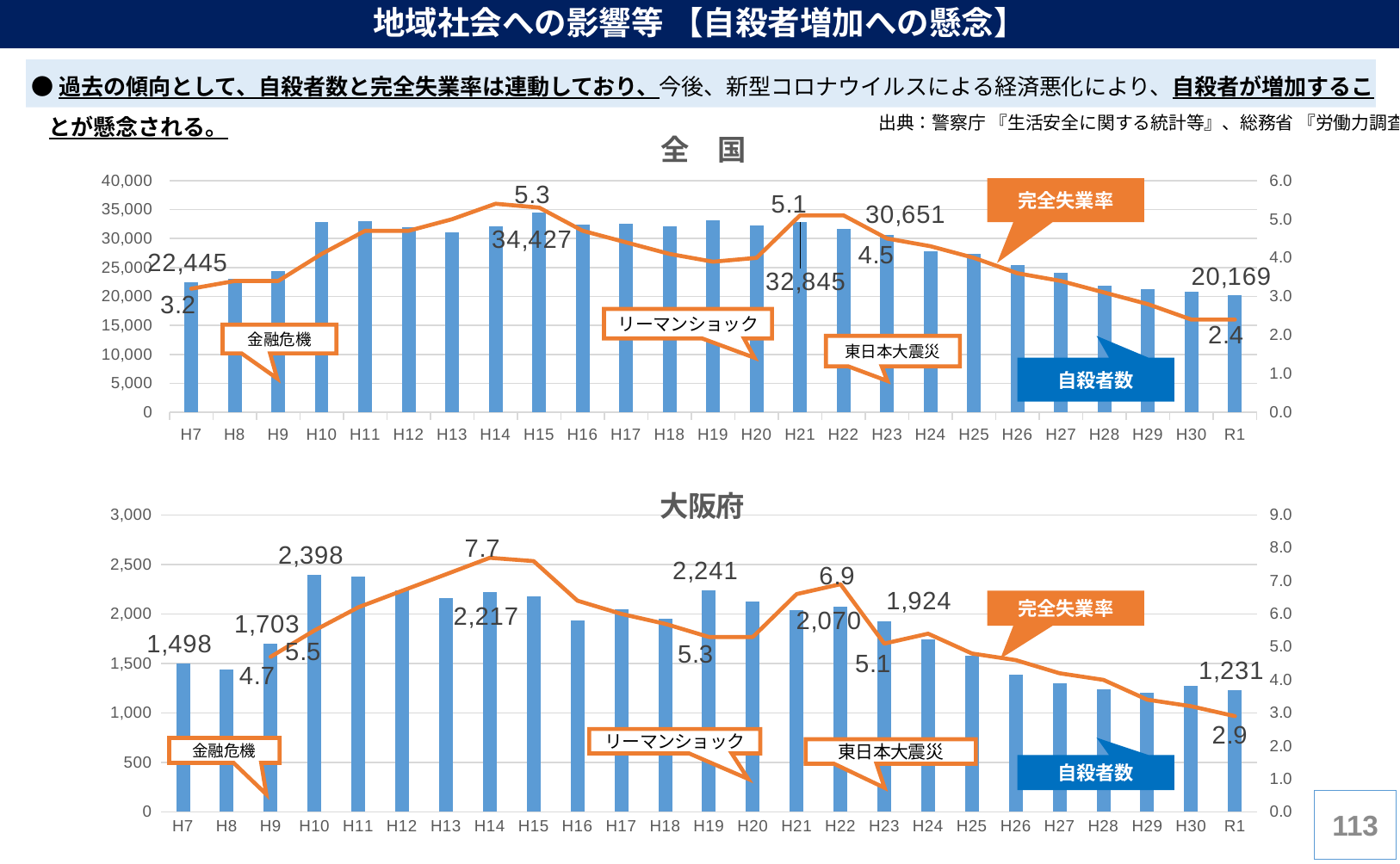
In the 全国 chart, what is the difference between the suicide counts labelled for H21 and H23? 2,194 In the 大阪府 chart, what is the number of suicides labelled for H10? 2,398 In the 全国 chart, what is the difference between the suicide counts labelled for H7 and R1? 2,276 In the 全国 chart, is the suicide count bar for H10 greater or less than 30,000? greater In the 全国 chart, does the unemployment rate line rise or fall from H26 to R1? fall In the 大阪府 chart, what is the number of suicides labelled for R1? 1,231 In the 大阪府 chart, what is the unemployment rate labelled for H14? 7.7 In the 全国 chart, what is the number of suicides (自殺者数) labelled for H15? 34,427 In the 大阪府 chart, which is larger, the suicide count for H19 or for H23? H19 In the 全国 chart, what is the unemployment rate (完全失業率) labelled for R1? 2.4 How many years (categories) are shown on the x axis of the 全国 chart? 25 In the 大阪府 chart, which year has the highest bar for suicides? H10